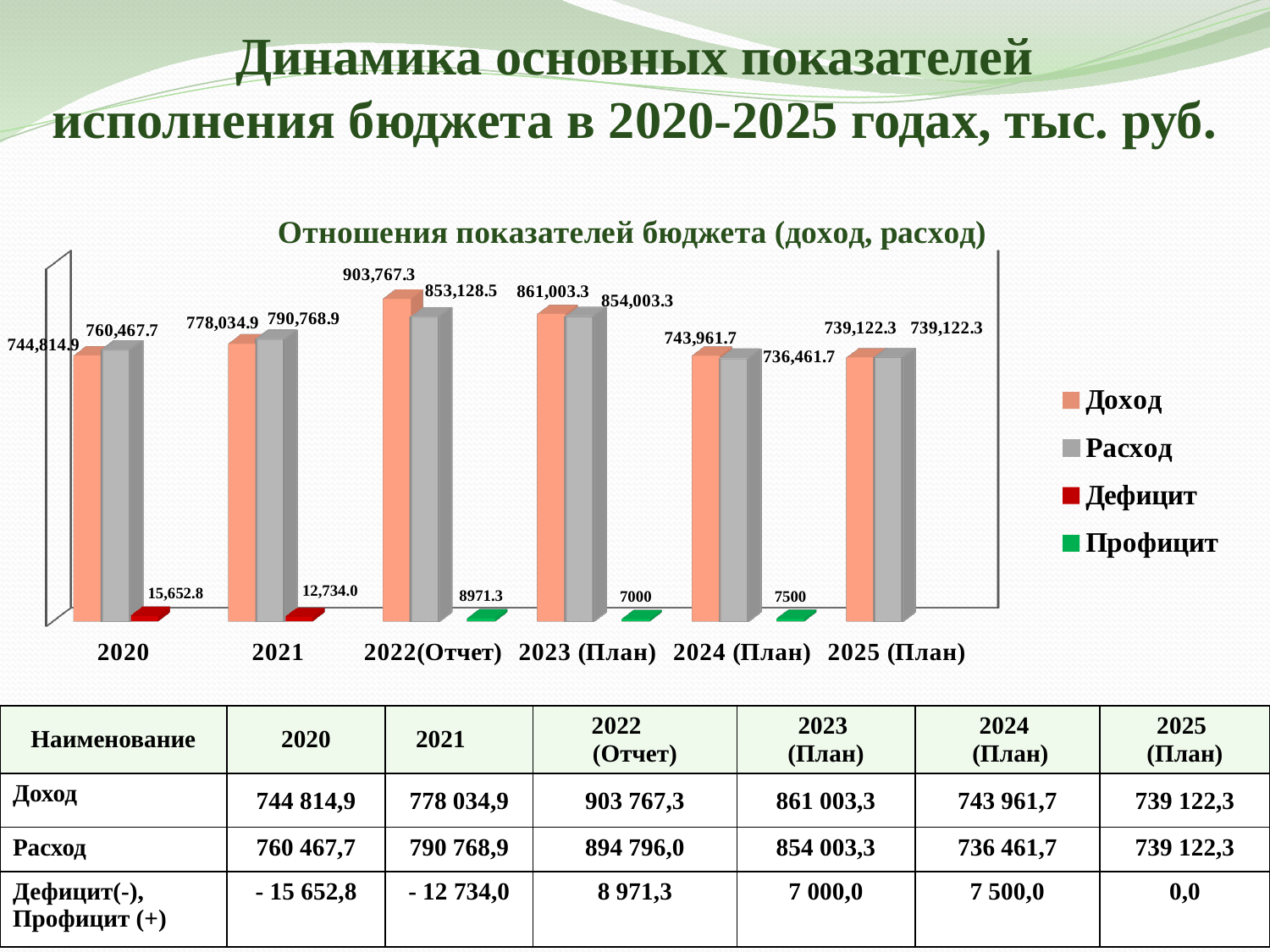
How many years are shown on the x axis of the chart? 6 How many series does the chart legend list? 4 What is the value of Доход for 2020? 744,814.9 What is the value of Расход for 2021? 790,768.9 What type of chart is shown on the slide? Bar chart In 2023 (План), which is larger, Доход or Расход? Доход In which year is Доход the highest? 2022(Отчет) What is the value of Дефицит for 2021? 12,734.0 Does Доход rise or fall from 2022(Отчет) to 2025 (План)? Fall What is the value of Профицит for 2024 (План)? 7500 In which year is Доход the lowest? 2025 (План) What is the difference between Расход and Доход in 2020? 15,652.8